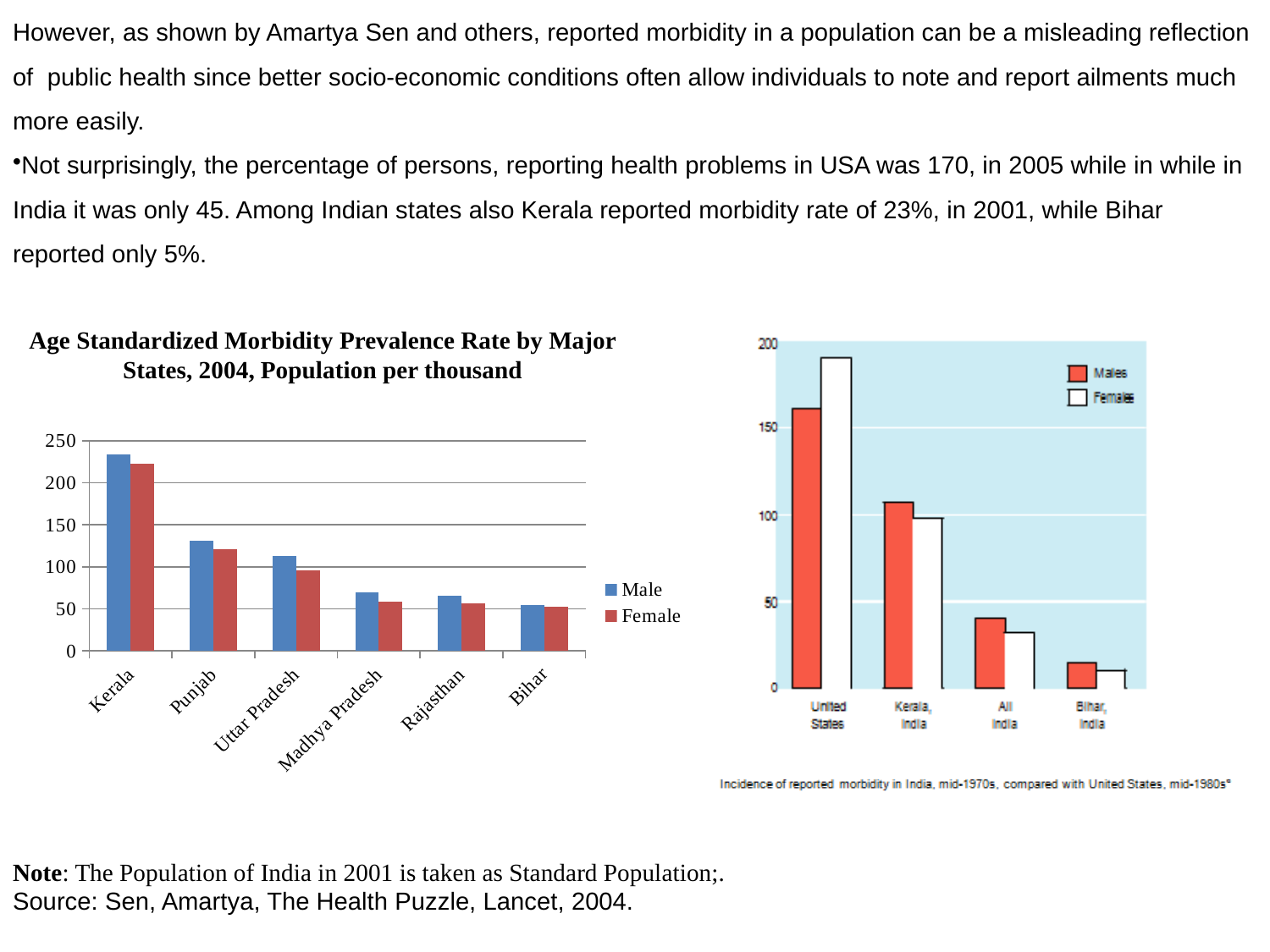
In the left chart (Age Standardized Morbidity Prevalence Rate by Major States), is the Female value for Punjab greater or less than 150? less In the left chart (Age Standardized Morbidity Prevalence Rate by Major States), how many series does the legend list? 2 In the left chart (Age Standardized Morbidity Prevalence Rate by Major States), is the Male value for Kerala greater or less than 200? greater In the right chart (Incidence of reported morbidity in India compared with United States), which category has the highest Females value? United States In the right chart (Incidence of reported morbidity in India compared with United States), how many categories are shown on the x axis? 4 In the left chart (Age Standardized Morbidity Prevalence Rate by Major States), do the Male values rise or fall moving from Kerala to Bihar along the x axis? Fall In the right chart (Incidence of reported morbidity in India compared with United States), is the Males value for All India greater or less than 50? less In the right chart (Incidence of reported morbidity in India compared with United States), is the Males value for United States larger or smaller than the Females value? Smaller In the left chart (Age Standardized Morbidity Prevalence Rate by Major States), how many states are shown on the x axis? 6 In the left chart (Age Standardized Morbidity Prevalence Rate by Major States), which state has the lowest Female value? Bihar In the left chart (Age Standardized Morbidity Prevalence Rate by Major States), which state has the highest Male value? Kerala What kind of chart is the left chart titled 'Age Standardized Morbidity Prevalence Rate by Major States, 2004'? Bar chart